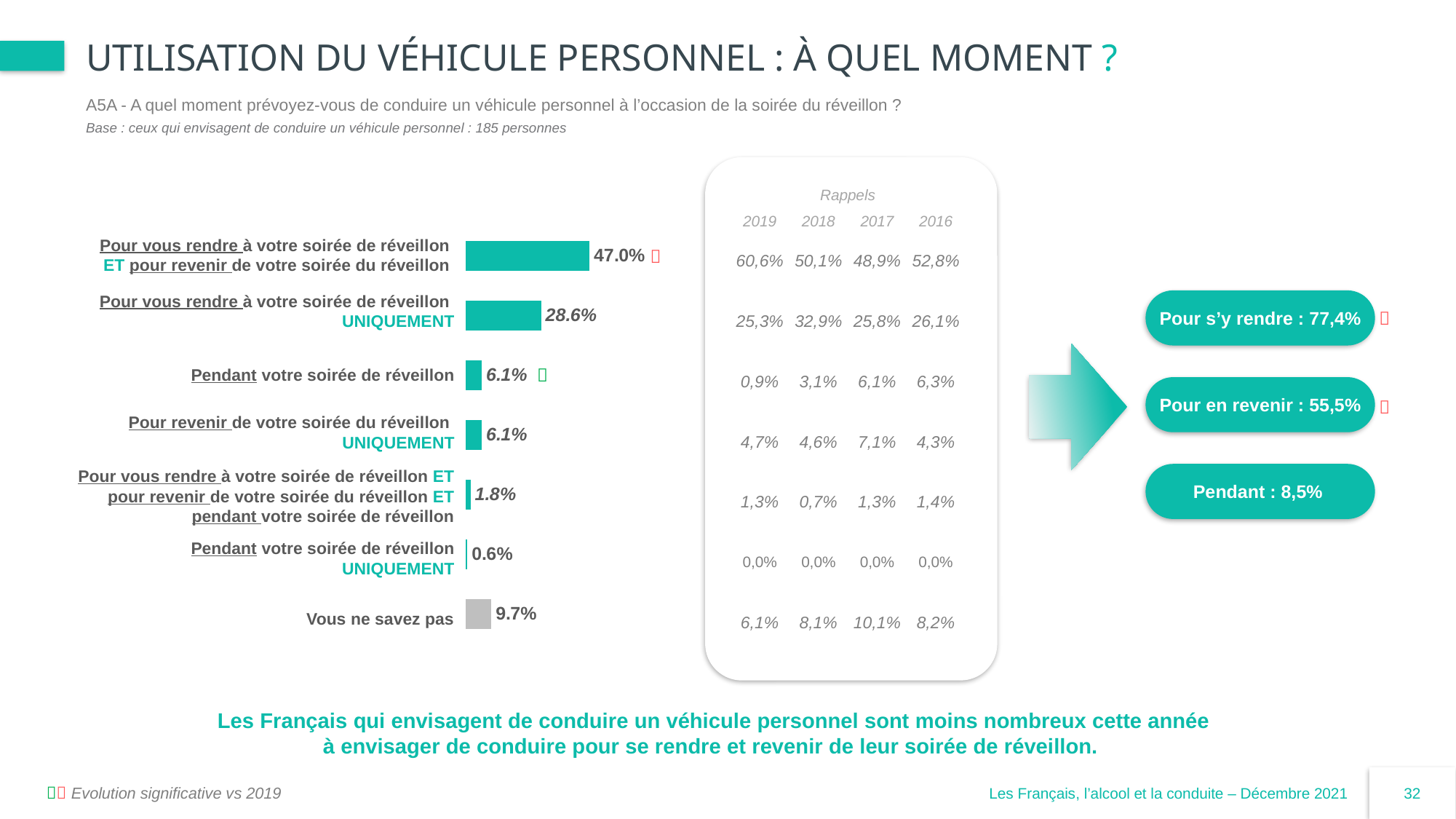
Which category has the lowest value? Pendant votre soirée de réveillon UNIQUEMENT What kind of chart is shown on the slide? bar chart What is the value for "Vous ne savez pas"? 9.7% What colour is the bar for "Vous ne savez pas"? grey What is the value for "Pour revenir de votre soirée du réveillon UNIQUEMENT"? 6.1% Which category has the highest value? Pour vous rendre à votre soirée de réveillon ET pour revenir de votre soirée du réveillon What is the value for "Pour vous rendre à votre soirée de réveillon UNIQUEMENT"? 28.6% What is the value for "Pendant votre soirée de réveillon UNIQUEMENT"? 0.6% What is the value for "Pour vous rendre à votre soirée de réveillon ET pour revenir de votre soirée du réveillon"? 47.0% How many categories are shown in the bar chart? 7 Which is larger: the value for "Vous ne savez pas" or the value for "Pendant votre soirée de réveillon"? Vous ne savez pas What is the difference between the value for "Pour vous rendre à votre soirée de réveillon ET pour revenir de votre soirée du réveillon" and the value for "Pour vous rendre à votre soirée de réveillon UNIQUEMENT"? 18.4%